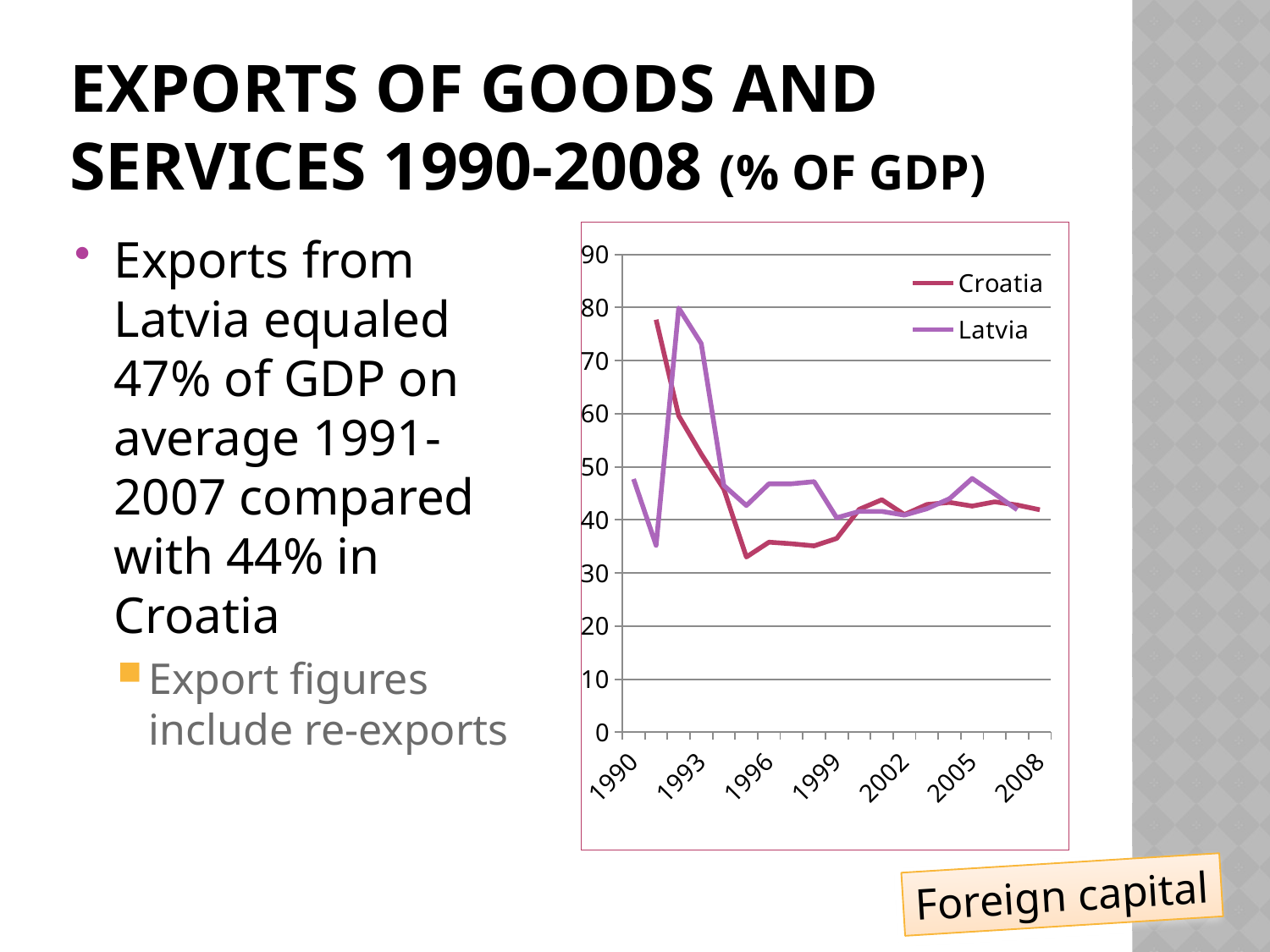
Is the value for Latvia in 1990 greater or less than 40? greater Is the value for Croatia in 1991 greater or less than 70? greater In 1996, which country has the higher value, Croatia or Latvia? Latvia What colour is the line for Latvia? purple Does the Croatia line rise or fall between 1991 and 1996? fall How many year labels are shown on the x axis? 7 What kind of chart is shown on the slide? line chart Is the value for Croatia in 1996 greater or less than 40? less Which two countries are shown in the chart's legend? Croatia and Latvia How many series does the chart's legend list? 2 In 1991, which country has the higher value, Croatia or Latvia? Croatia